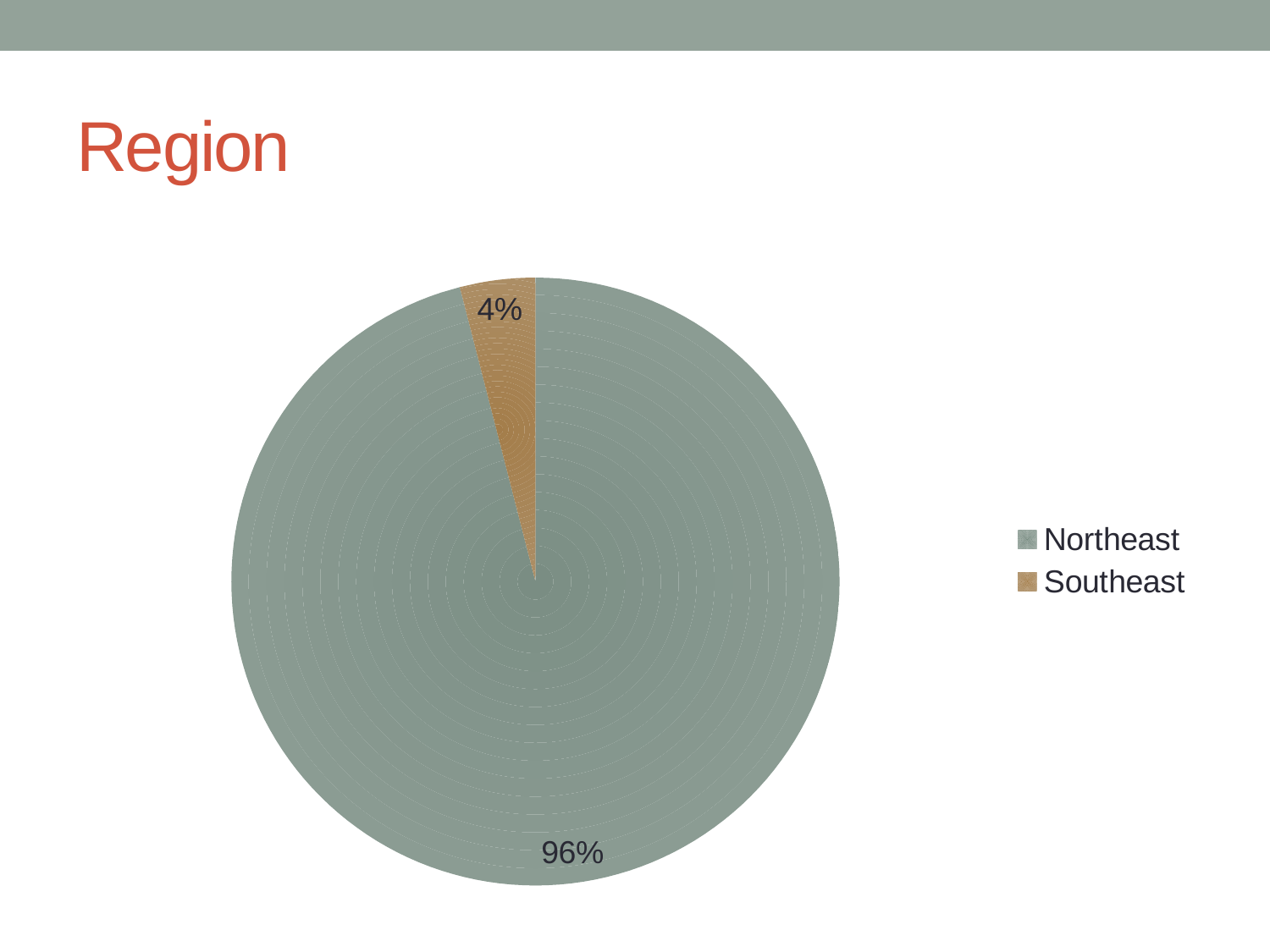
Which region is shown in the tan/brown colour in the legend? Southeast Which region has the largest slice of the pie? Northeast How many entries does the legend list? 2 What kind of chart is shown on the slide? pie chart Which region has the smallest slice of the pie? Southeast What is the difference in percentage points between the Northeast and Southeast slices? 92 What is the title of the slide containing the chart? Region What share of the pie does Southeast represent? 4% How many slices does the pie chart have? 2 What share of the pie does Northeast represent? 96% Which is larger, the Northeast slice or the Southeast slice? Northeast